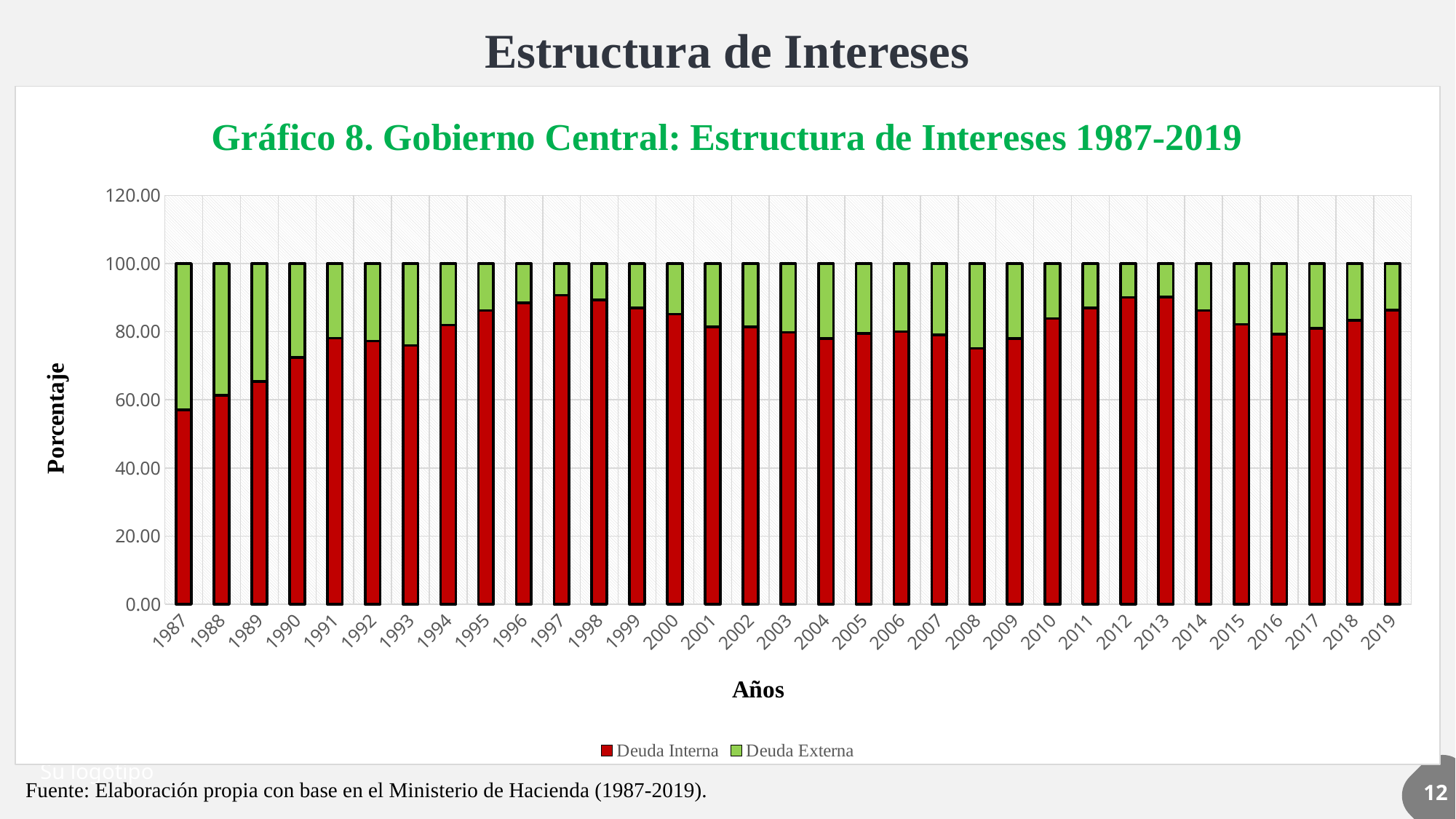
Which year has the highest value for Deuda Externa? 1987 What is the total height of the stacked bar for 2010? 100.00 Does the Deuda Interna share rise or fall from 1987 to 1997? rise Is the value for Deuda Interna in 1987 greater or less than 60.00? less Is the value for Deuda Interna in 2008 greater or less than 80.00? less What kind of chart is shown on the slide? Stacked bar chart Is the value for Deuda Interna in 1997 greater or less than 80.00? greater How many years are plotted along the x axis? 33 Which is larger, the Deuda Interna value for 1987 or for 2019? 2019 How many series does the legend list? 2 Which year has the lowest value for Deuda Interna? 1987 What is the label on the y axis? Porcentaje